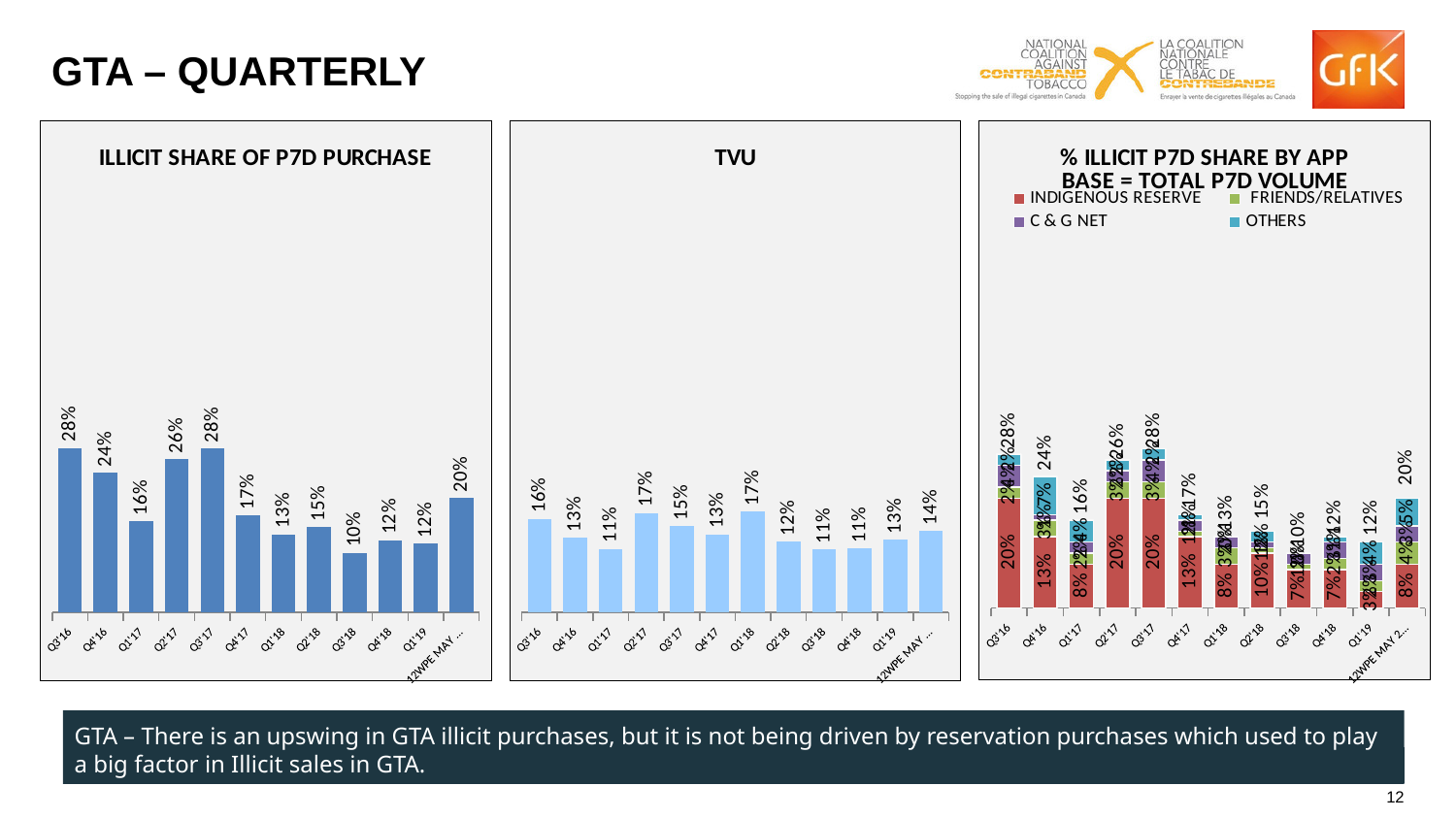
In the ILLICIT SHARE OF P7D PURCHASE chart, how many bars are plotted? 12 In the TVU chart, what is the difference between Q1'18 and Q2'18? 5% What kind of chart is the TVU chart? Bar chart In the ILLICIT SHARE OF P7D PURCHASE chart, which category has the lowest value? Q3'18 In the % ILLICIT P7D SHARE BY APP chart, what is the INDIGENOUS RESERVE value for Q3'16? 20% In the ILLICIT SHARE OF P7D PURCHASE chart, what is the value for Q3'18? 10% How many series does the legend of the % ILLICIT P7D SHARE BY APP chart list? 4 In the TVU chart, what is the value for Q2'17? 17% In the ILLICIT SHARE OF P7D PURCHASE chart, what is the value for Q3'16? 28% In the ILLICIT SHARE OF P7D PURCHASE chart, what is the difference between Q2'17 and Q1'17? 10% In the TVU chart, which is larger, the value for Q3'16 or the value for Q4'16? Q3'16 In the TVU chart, what is the value for Q1'19? 13%